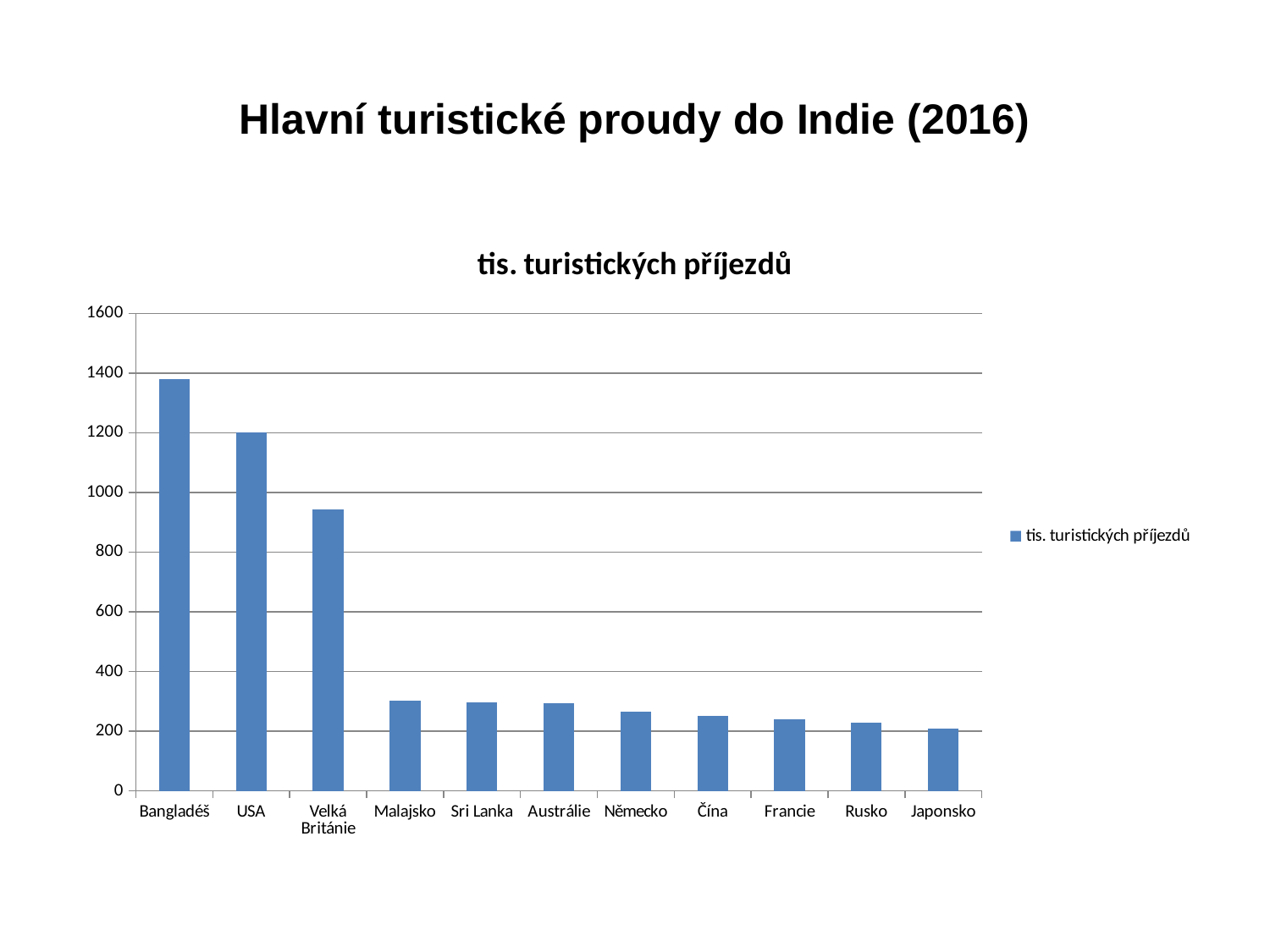
Which country has the highest value in the chart? Bangladéš Which has a larger value, Bangladéš or USA? Bangladéš What kind of chart is shown on the slide? bar chart Which has a larger value, Velká Británie or Malajsko? Velká Británie Do the values rise or fall from left to right along the x axis? fall Is the value for Bangladéš greater or less than 1200? greater What is the title of the chart? tis. turistických příjezdů Is the value for Malajsko greater or less than 400? less How many series does the legend list? 1 Is the value for Velká Británie greater or less than 1000? less How many countries are shown on the x axis of the chart? 11 Which country has the lowest value in the chart? Japonsko